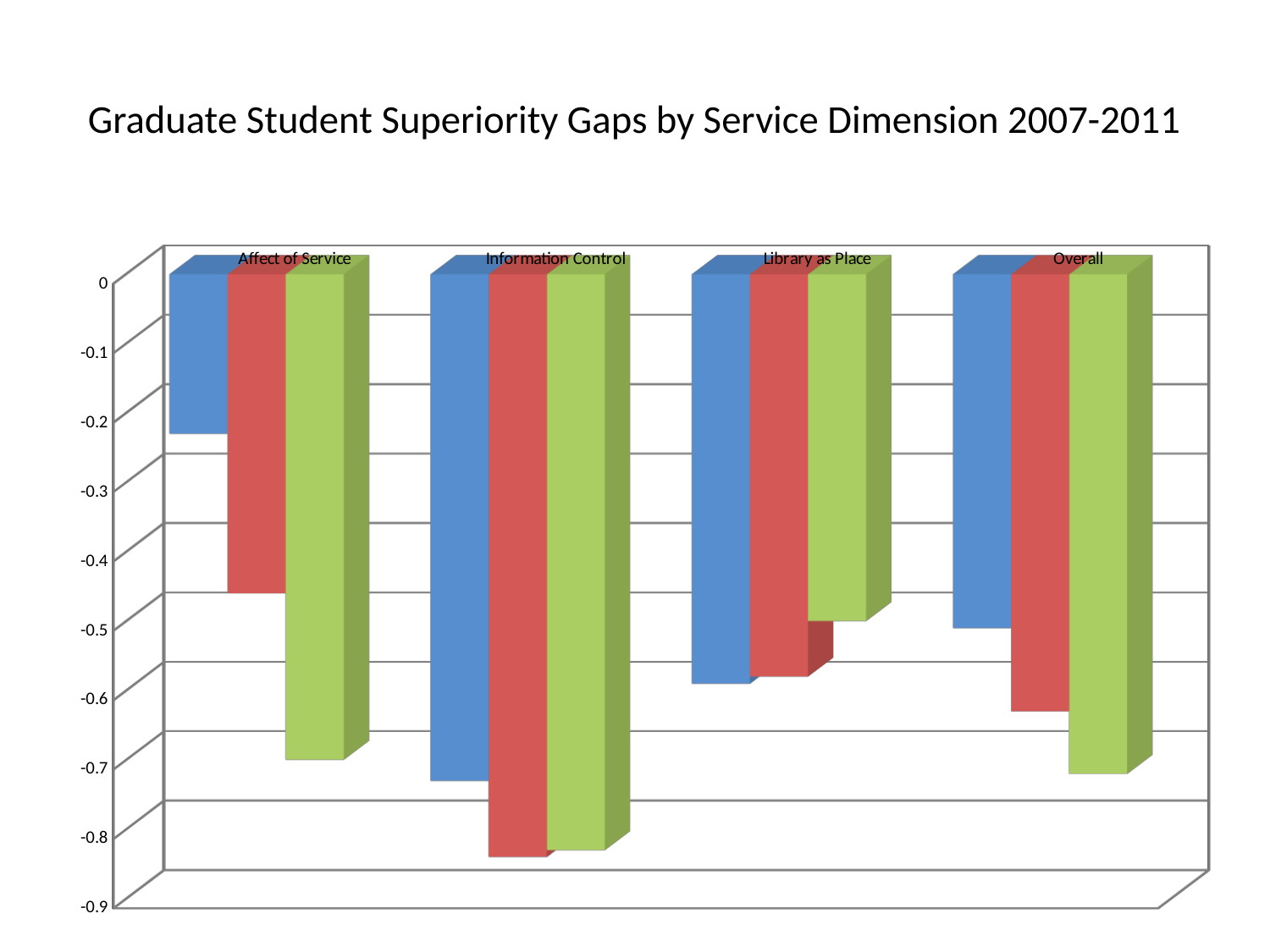
How many service dimension categories are shown on the x axis? 4 Is the blue bar for Affect of Service higher or lower than the blue bar for Information Control? Higher Is the value of the blue bar for Affect of Service greater or less than -0.1? less Which category has the blue bar closest to zero? Affect of Service Is the value of the green bar for Affect of Service greater or less than -0.5? less What type of chart is shown on the slide? Bar chart How many bars are plotted for each category? 3 Which category has the lowest (most negative) values overall? Information Control In the Library as Place category, which coloured bar is closest to zero? Green Is the value of the blue bar for Information Control greater or less than -0.6? less What is the title of the chart? Graduate Student Superiority Gaps by Service Dimension 2007-2011